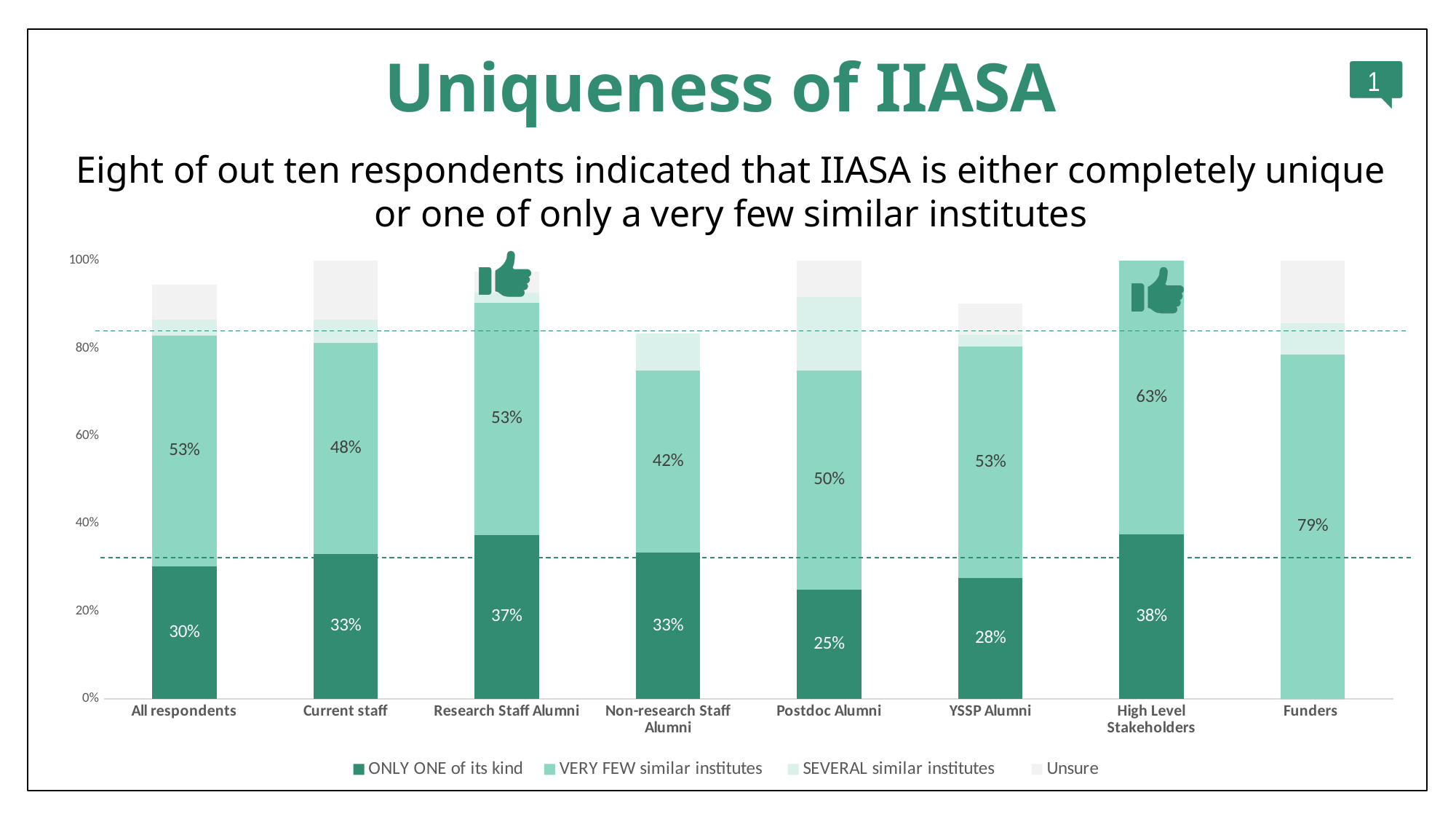
For High Level Stakeholders, what is the difference between the VERY FEW similar institutes value and the ONLY ONE of its kind value? 25 percentage points How many series does the legend list? 4 Which group has the lowest labelled ONLY ONE of its kind value? Postdoc Alumni What percentage of All respondents said IIASA is the ONLY ONE of its kind? 30% What is the VERY FEW similar institutes value for Funders? 79% Which group has the highest ONLY ONE of its kind value? High Level Stakeholders Which group has the lowest VERY FEW similar institutes value? Non-research Staff Alumni Which is larger: the ONLY ONE of its kind value for Research Staff Alumni or for YSSP Alumni? Research Staff Alumni What kind of chart is shown on the slide? Stacked bar chart What is the title of the slide containing the chart? Uniqueness of IIASA What is the ONLY ONE of its kind value for Postdoc Alumni? 25% How many respondent groups are shown along the x axis? 8